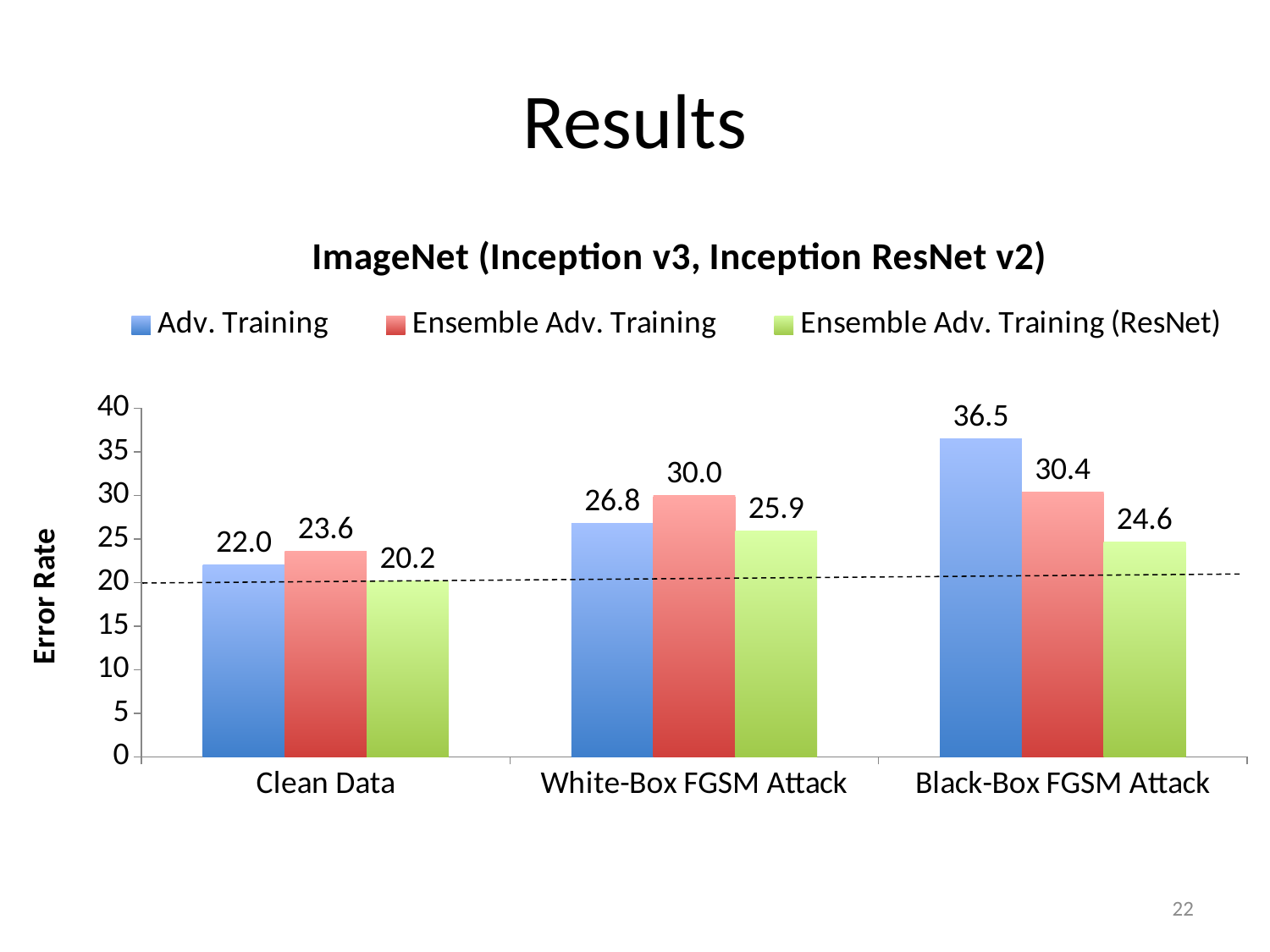
Which series has the highest error rate under the Black-Box FGSM Attack? Adv. Training What is the error rate for Adv. Training on Clean Data? 22.0 How many series does the legend list? 3 How many categories are shown on the x axis? 3 Is the error rate for Ensemble Adv. Training under the Black-Box FGSM Attack greater or less than 25? greater What is the title of the chart? ImageNet (Inception v3, Inception ResNet v2) What is the difference between the Adv. Training error rate under the Black-Box FGSM Attack and on Clean Data? 14.5 What is the error rate for Ensemble Adv. Training (ResNet) under the Black-Box FGSM Attack? 24.6 What kind of chart is shown on the slide? Bar chart Under the White-Box FGSM Attack, which has a higher error rate: Adv. Training or Ensemble Adv. Training? Ensemble Adv. Training Which series has the lowest error rate on Clean Data? Ensemble Adv. Training (ResNet) What is the error rate for Ensemble Adv. Training under the White-Box FGSM Attack? 30.0